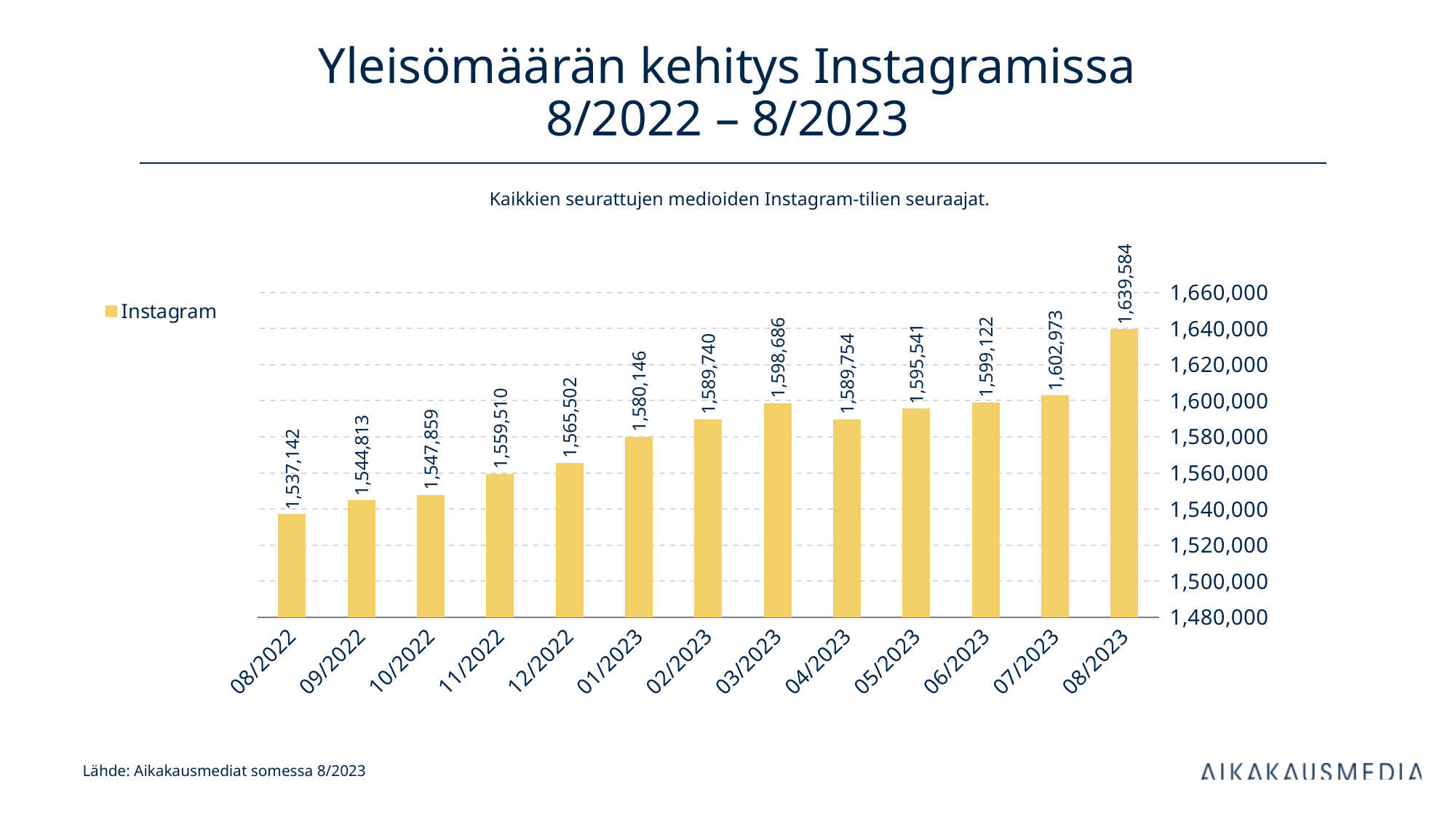
What was the Instagram follower count in 03/2023? 1,598,686 Which month had more Instagram followers, 12/2022 or 01/2023? 01/2023 What was the Instagram follower count in 08/2022? 1,537,142 Which month has the lowest Instagram follower count? 08/2022 By how much did the Instagram follower count drop from 03/2023 to 04/2023? 8,932 What kind of chart is shown on the slide? Bar chart Which month has the highest Instagram follower count? 08/2023 What is the difference in Instagram followers between 08/2023 and 08/2022? 102,442 What is the overall trend of Instagram followers from 08/2022 to 08/2023? Rising Is the value for 01/2023 greater or less than 1,600,000? less How many months are shown on the x axis? 13 What was the Instagram follower count in 08/2023? 1,639,584